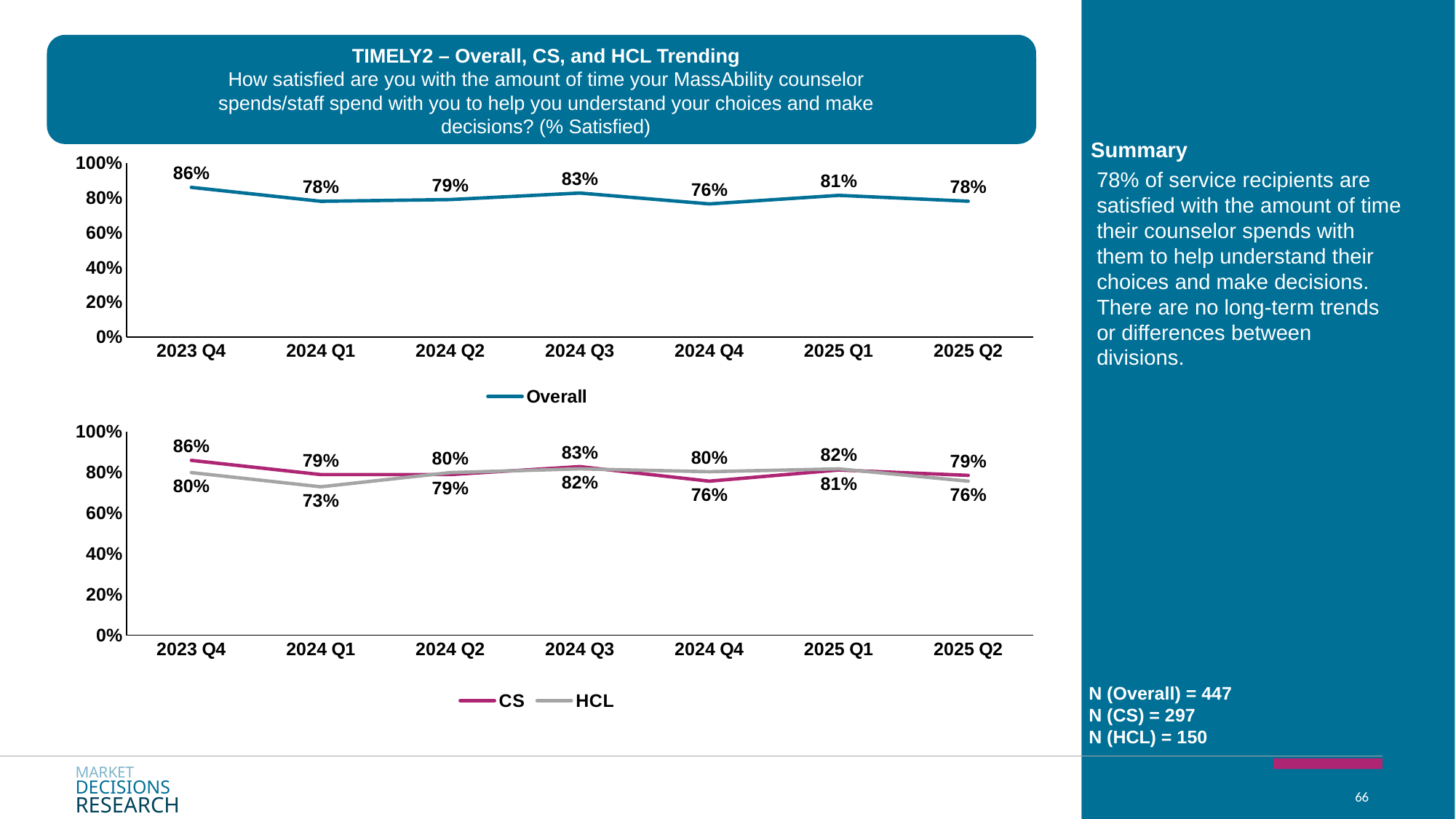
In the bottom chart, what is the CS value for 2024 Q1? 79% In the top chart (Overall), what is the value for 2023 Q4? 86% What type of chart is the top chart? Line chart In the bottom chart, what is the difference between CS and HCL at 2023 Q4? 6% In the top chart (Overall), what is the difference between the 2023 Q4 value and the 2025 Q2 value? 8% In the top chart (Overall), which quarter has the highest value? 2023 Q4 How many quarters are plotted on the x axis of the top chart? 7 In the top chart (Overall), what is the value for 2024 Q4? 76% How many series does the legend of the bottom chart list? 2 In the bottom chart, what is the HCL value for 2024 Q1? 73% In the top chart (Overall), which quarter has the lowest value? 2024 Q4 In the bottom chart, which series is higher at 2024 Q4, CS or HCL? HCL